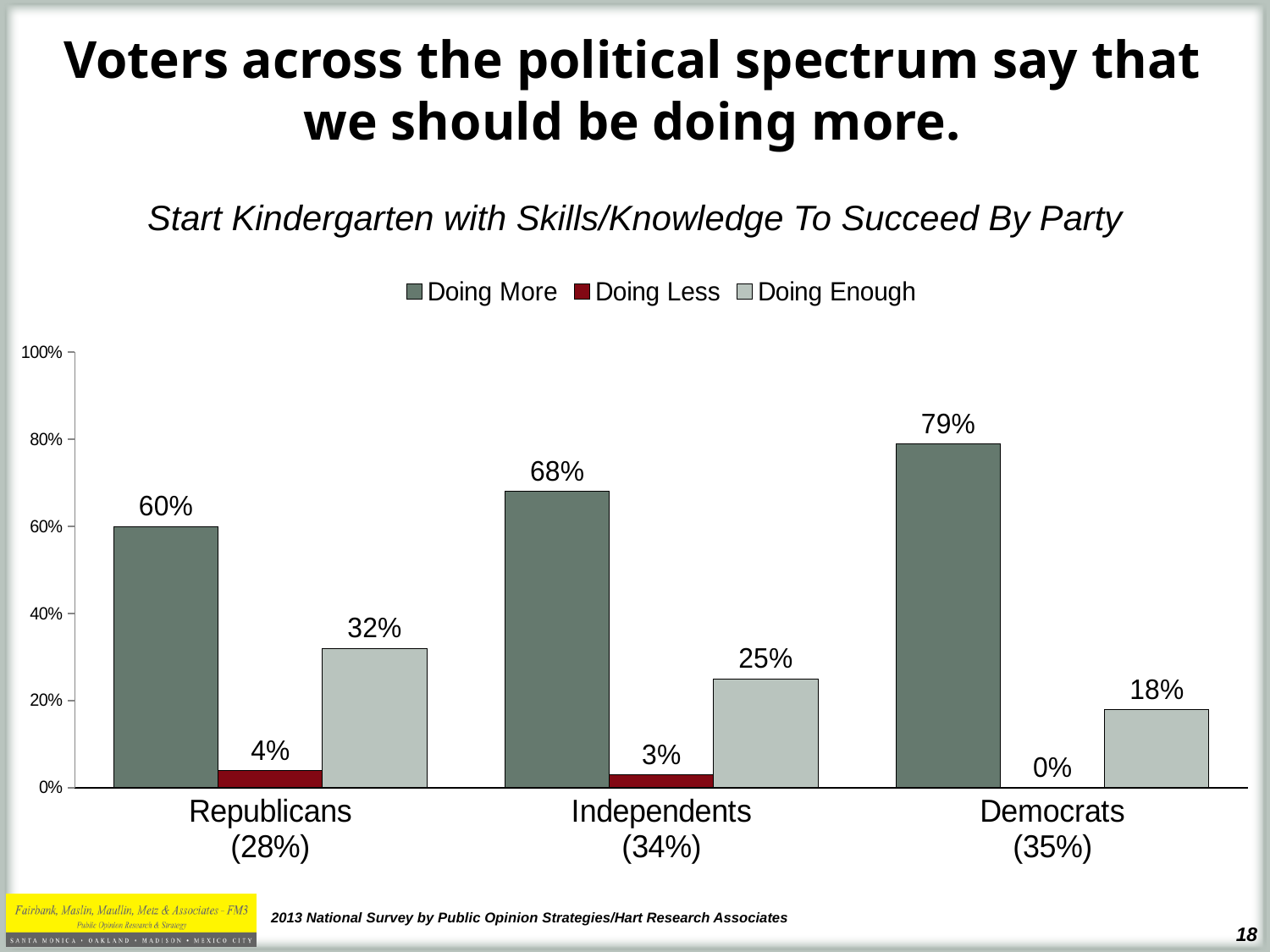
How many party categories are shown on the x axis? 3 Which party has the lowest "Doing Enough" value? Democrats What kind of chart is shown on the slide? Bar chart What is the title of the chart? Start Kindergarten with Skills/Knowledge To Succeed By Party Which is larger: the "Doing Enough" value for Republicans or for Independents? Republicans What is the "Doing Less" value for Independents? 3% What is the difference between the "Doing More" values for Democrats and Republicans? 19% How many series does the legend list? 3 What is the "Doing Enough" value for Democrats? 18% Which party has the highest "Doing More" value? Democrats Is the "Doing More" value for Independents greater or less than 60%? greater What percentage of Republicans say we are "Doing More"? 60%